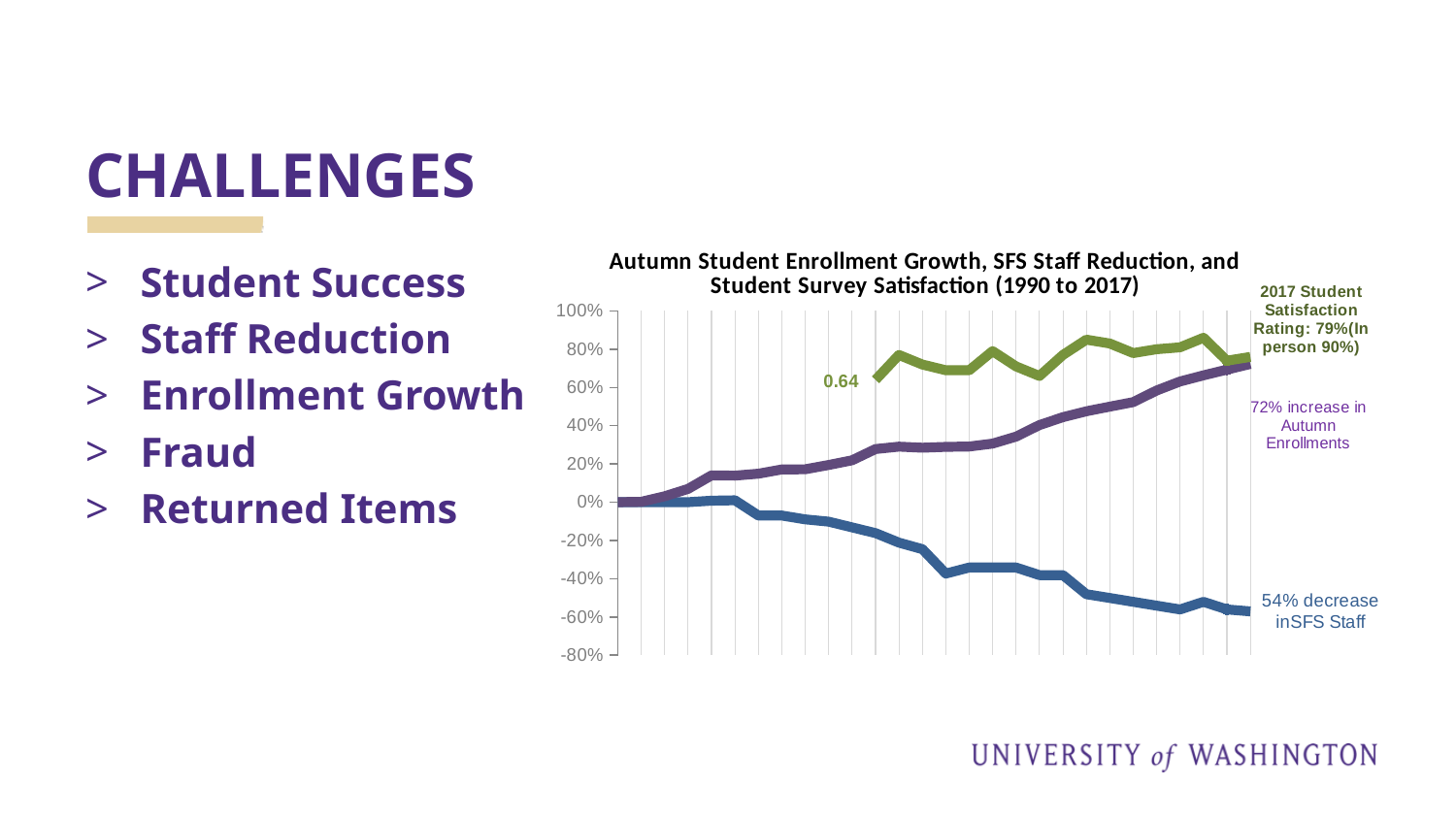
What is the 2017 in-person student satisfaction rating shown on the chart? 90% Is the final value of the SFS Staff line greater or less than -40%? less What is the title of the chart? Autumn Student Enrollment Growth, SFS Staff Reduction, and Student Survey Satisfaction (1990 to 2017) At the right end of the chart, which line is higher: Student Satisfaction or SFS Staff? Student Satisfaction Does the Autumn Enrollments line rise or fall from left to right? rise Does the SFS Staff line rise or fall from left to right? fall By what percentage did SFS Staff decrease according to the chart annotation? 54% By what percentage did Autumn Enrollments increase according to the chart annotation? 72% How many lines are plotted on the chart? 3 What is the 2017 Student Satisfaction Rating shown on the chart? 79% What value is labelled at the start of the Student Satisfaction line? 0.64 What kind of chart is shown on the slide? line chart